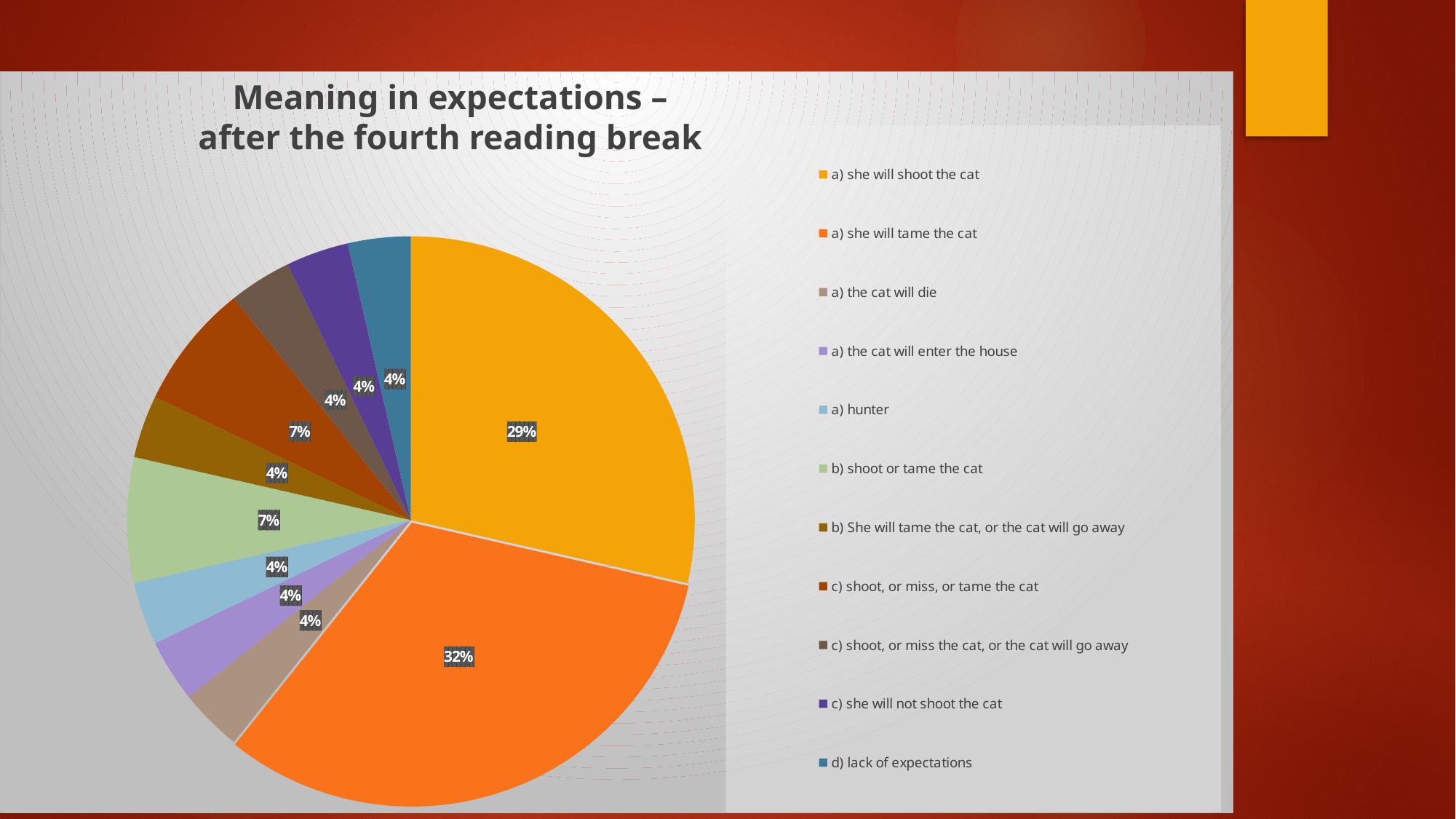
What is the difference in percentage points between 'a) she will tame the cat' and 'a) she will shoot the cat'? 3 What share of the pie is 'c) shoot, or miss, or tame the cat'? 7% How many entries does the legend list? 11 What is the difference in percentage points between 'c) shoot, or miss, or tame the cat' and 'a) hunter'? 3 What share of the pie is 'b) shoot or tame the cat'? 7% Which category has the largest slice of the pie? a) she will tame the cat What share of the pie is 'd) lack of expectations'? 4% What is the title of the chart? Meaning in expectations – after the fourth reading break What kind of chart is shown on the slide? pie chart Which is larger, 'a) she will shoot the cat' or 'a) she will tame the cat'? a) she will tame the cat